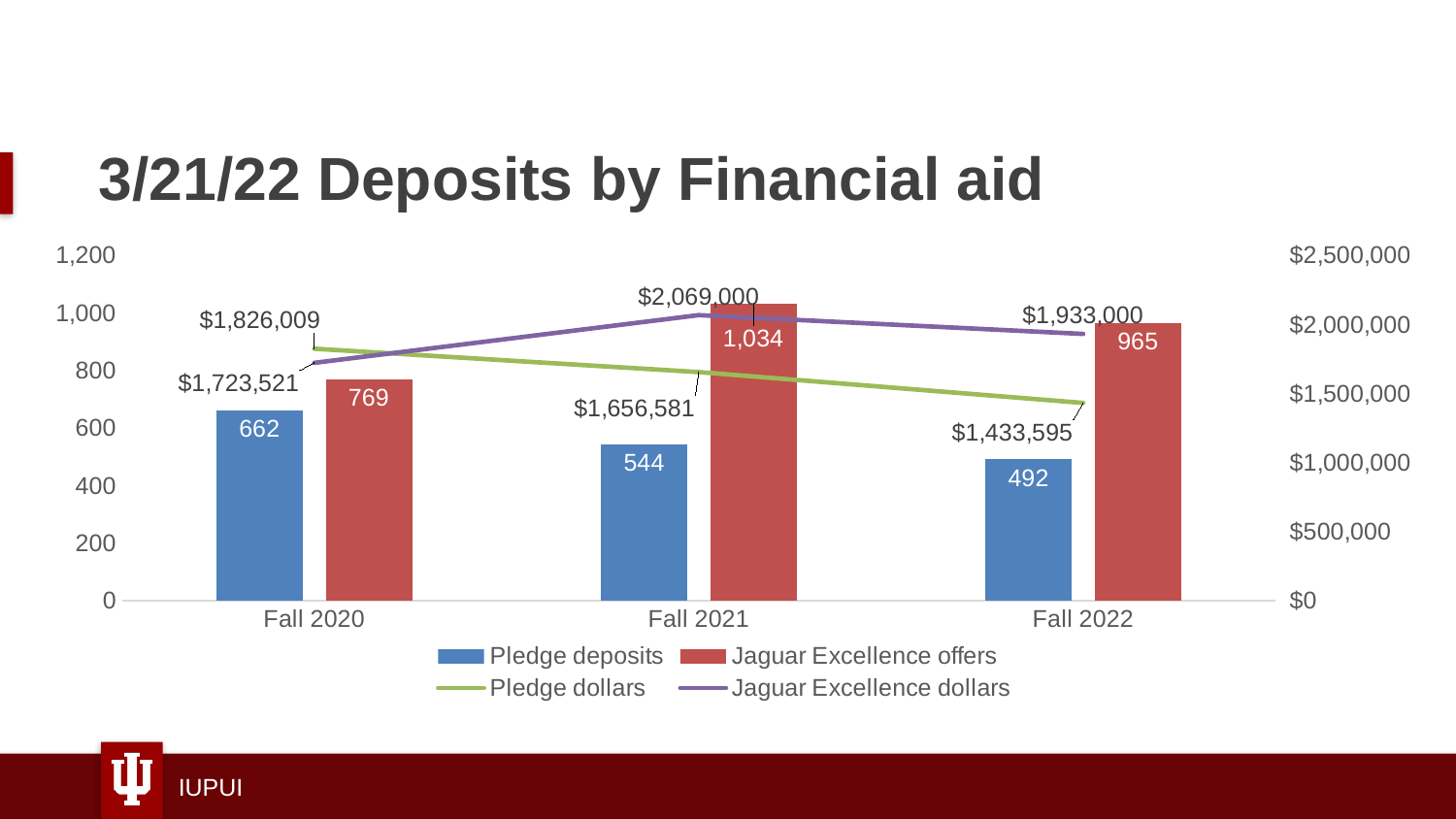
In which term are Jaguar Excellence offers highest? Fall 2021 How many terms are shown on the x axis? 3 In which term are Pledge deposits lowest? Fall 2022 What is the value of Pledge deposits for Fall 2021? 544 In Fall 2021, which is larger: Pledge deposits or Jaguar Excellence offers? Jaguar Excellence offers What is the value of Jaguar Excellence dollars for Fall 2021? $2,069,000 What is the value of Jaguar Excellence offers for Fall 2022? 965 What is the difference between Jaguar Excellence offers and Pledge deposits in Fall 2020? 107 Do Pledge deposits rise or fall from Fall 2020 to Fall 2022? Fall How many series does the legend list? 4 By how much did Jaguar Excellence dollars fall from Fall 2021 to Fall 2022? $136,000 What is the value of Pledge dollars for Fall 2020? $1,826,009